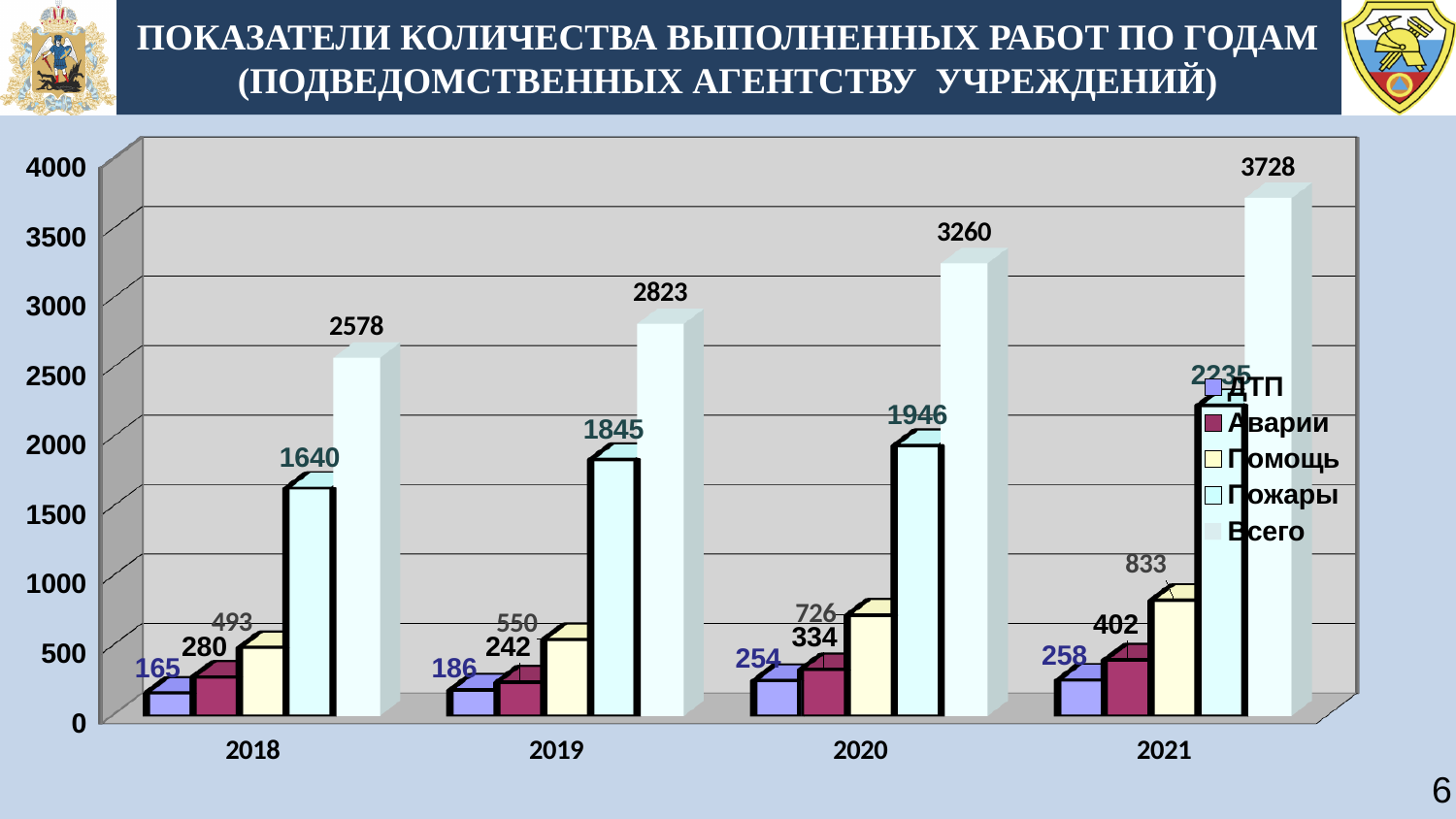
How many series does the legend list? 5 What is the value of Всего for 2021? 3728 What is the value of Помощь for 2020? 726 What kind of chart is shown on the slide? Bar chart What is the value of ДТП for 2018? 165 Which year has the lowest value for Аварии? 2019 What is the value of Пожары for 2019? 1845 What is the difference between the Всего values for 2021 and 2020? 468 Do the Всего values rise or fall from 2018 to 2021? Rise Which year has the highest value for Всего? 2021 Which is larger: Помощь in 2019 or Помощь in 2021? Помощь in 2021 How many years are shown on the x axis? 4